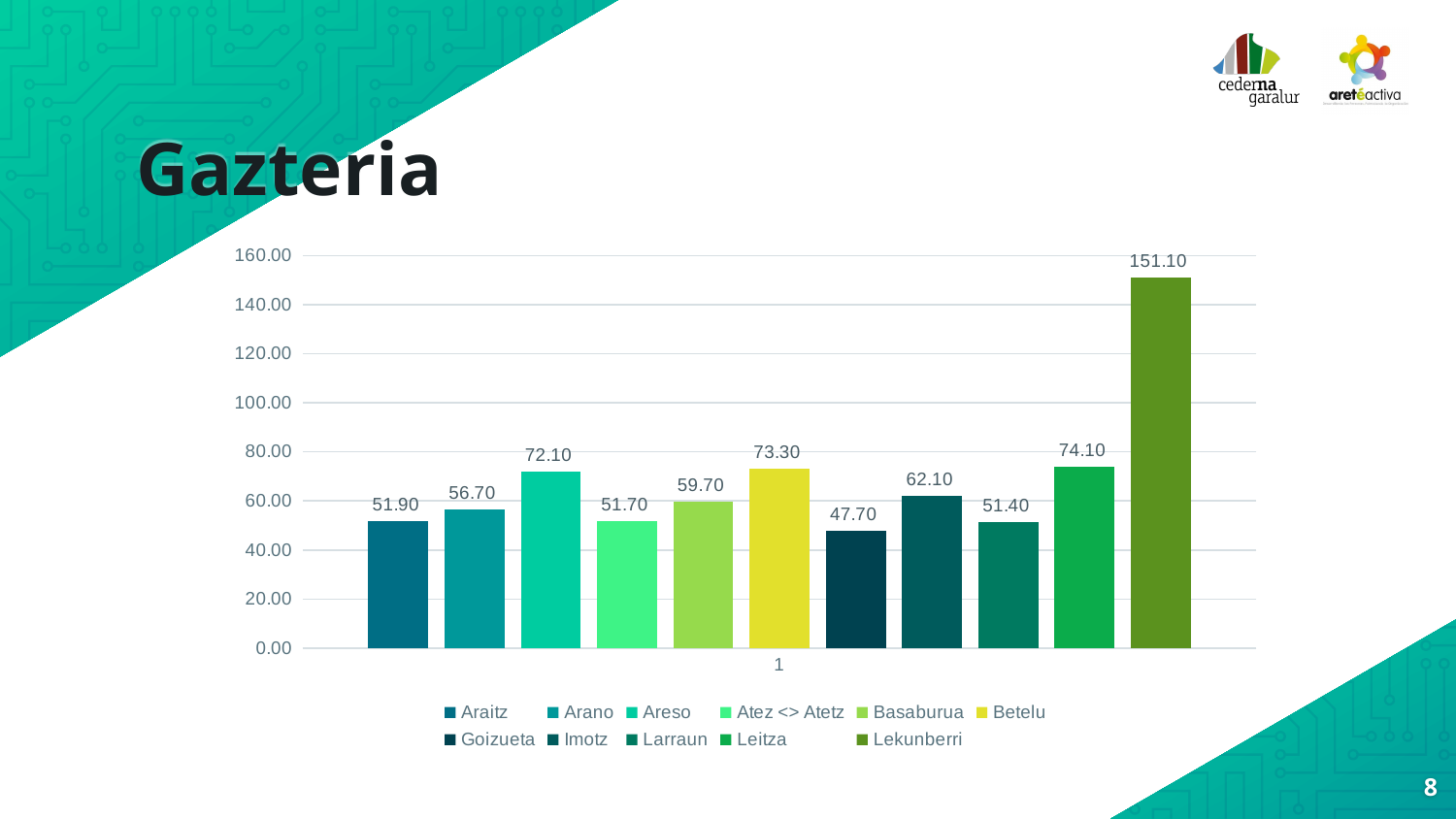
Which series has the highest value? Lekunberri Which series has the lowest value? Goizueta What kind of chart is shown on the slide? bar chart What is the difference between the values for Lekunberri and Leitza? 77.00 What is the value for Goizueta? 47.70 What is the value for Betelu? 73.30 What is the value for Lekunberri? 151.10 How many series does the legend list? 11 What is the difference between the values for Imotz and Arano? 5.40 Is the value for Lekunberri greater or less than 140? greater Which is larger, the value for Areso or the value for Imotz? Areso What is the value for Basaburua? 59.70